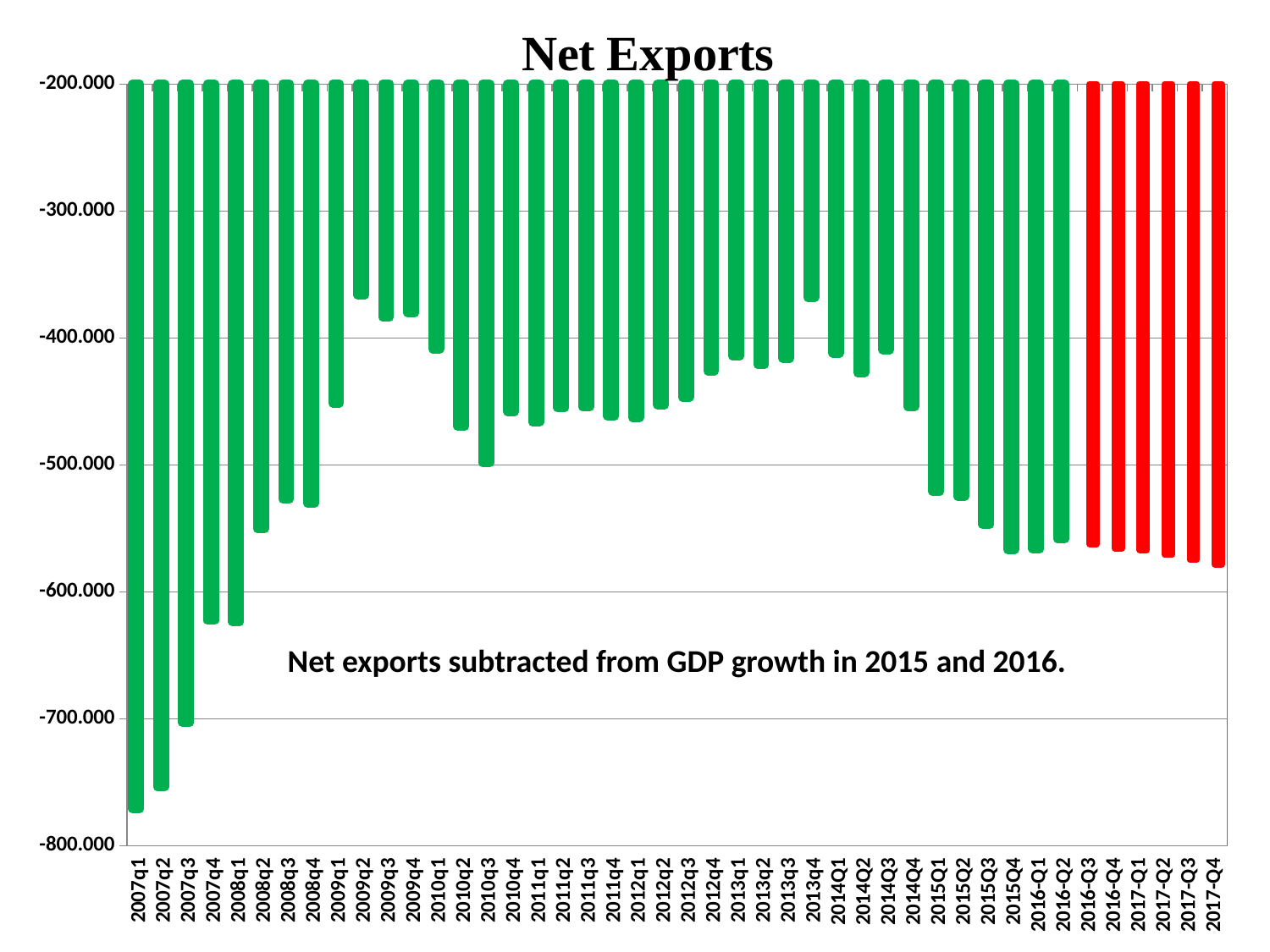
Is the value for 2009q2 greater or less than -400.000? greater What is the title of the chart? Net Exports Is the value for 2008q1 greater or less than -600.000? less Which has the more negative net exports value, 2007q1 or 2017-Q4? 2007q1 Is the value for 2017-Q4 greater or less than -600.000? greater What kind of chart is shown on the slide? bar chart What colour are the bars for the 2017 quarters? red Do the values rise or fall from 2013q4 to 2017-Q4? fall How many quarterly bars are plotted in the chart? 44 Do the values rise or fall from 2007q1 to 2009q2? rise Which quarter has the lowest (most negative) net exports value? 2007q1